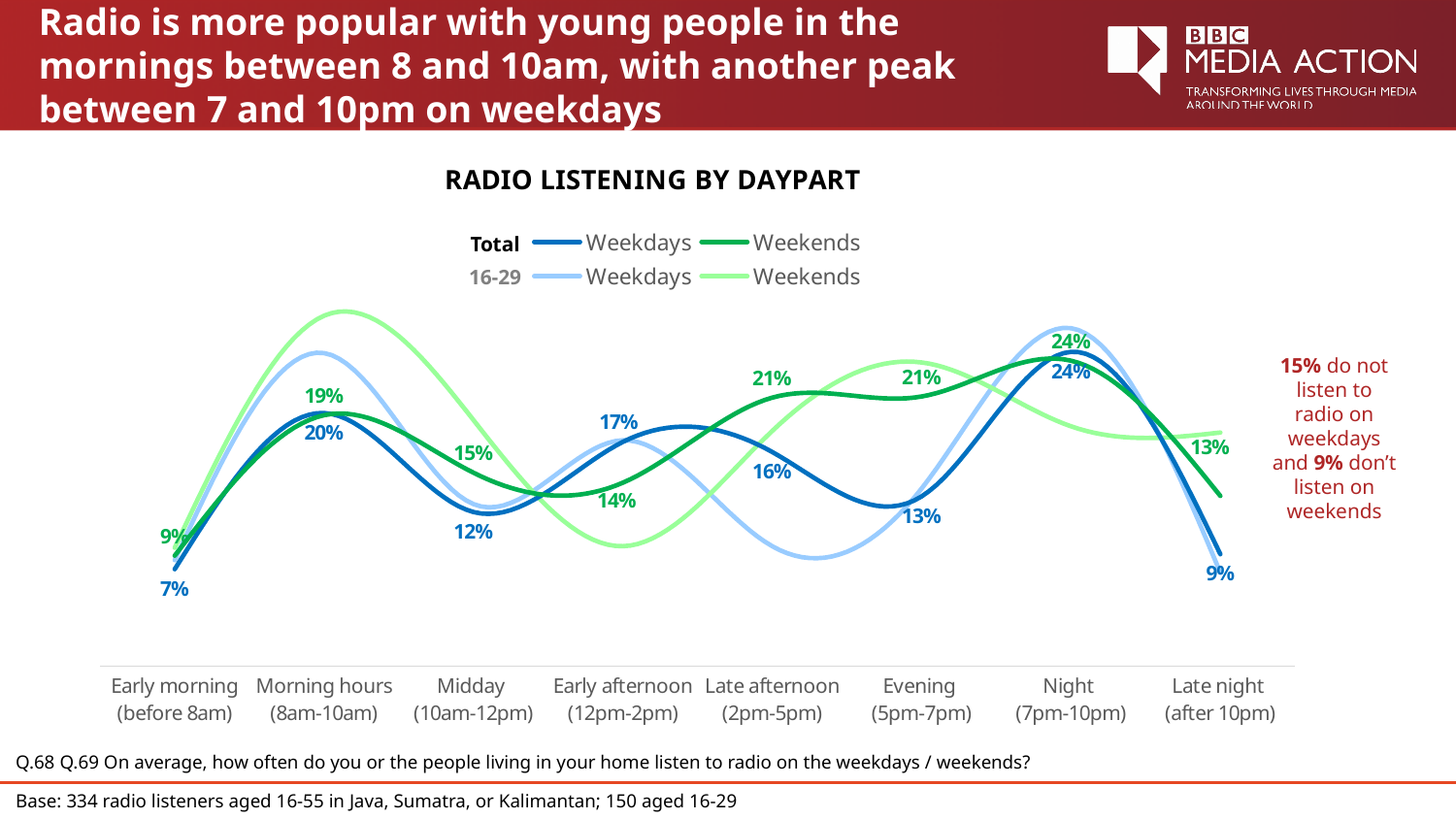
For Midday (10am-12pm), which is larger: the Total Weekdays value or the Total Weekends value? Total Weekends How many series does the chart's legend list? 4 What is the Total Weekdays value for Morning hours (8am-10am)? 20% How many dayparts are shown along the x axis? 8 What type of chart is shown on the slide? Line chart What is the Total Weekdays value for Early morning (before 8am)? 7% Does the Total Weekdays value rise or fall from Night (7pm-10pm) to Late night (after 10pm)? Fall Which daypart has the highest Total Weekdays value? Night (7pm-10pm) What is the Total Weekends value for Late afternoon (2pm-5pm)? 21% Which daypart has the lowest Total Weekdays value? Early morning (before 8am) What is the title of the chart? RADIO LISTENING BY DAYPART What is the difference between the Total Weekends and Total Weekdays values for Evening (5pm-7pm)? 8%